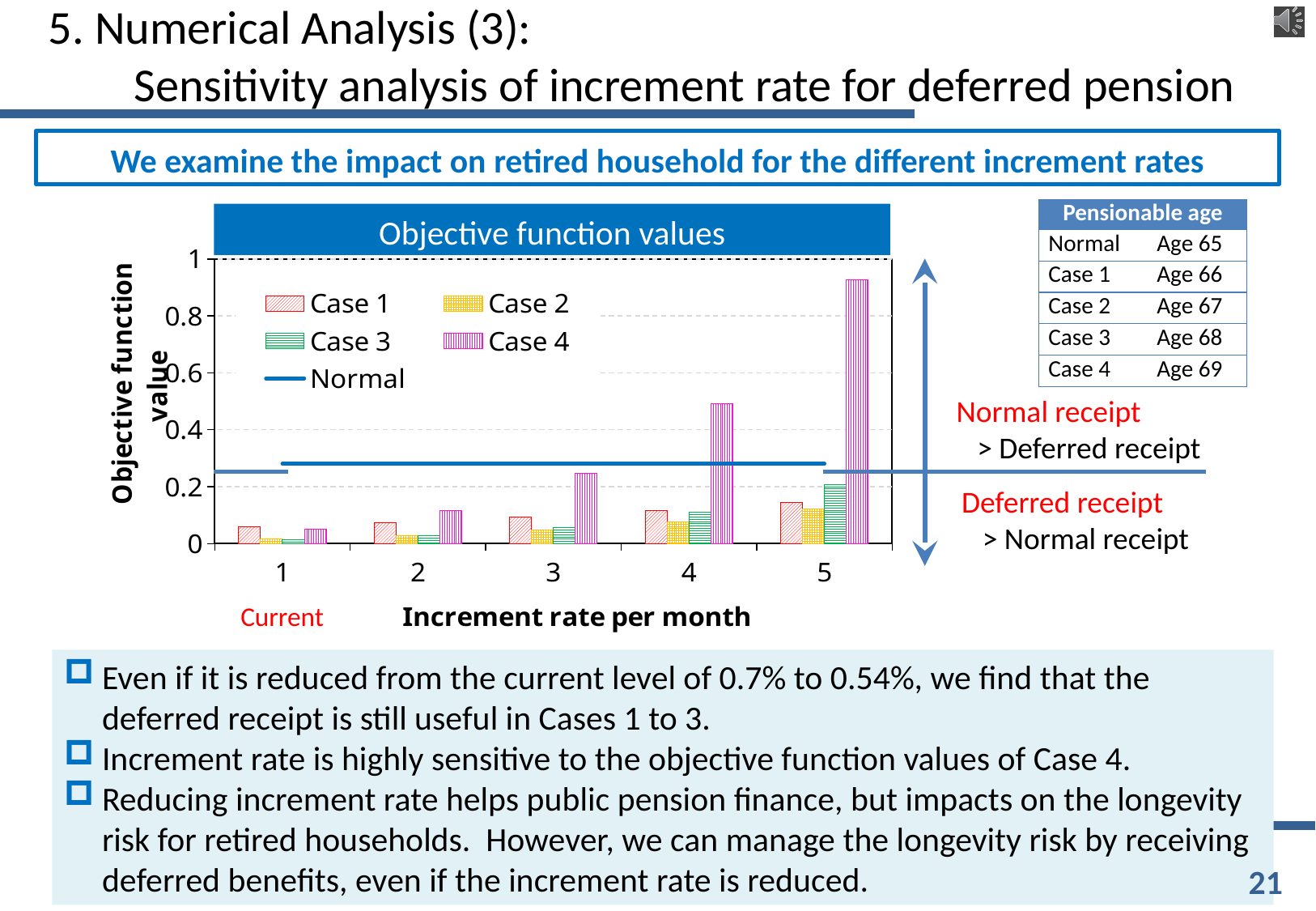
How many increment rate categories are shown on the x axis of the chart? 5 Is the value for Case 4 at increment rate 4 greater or less than 0.6? less Is the value for Case 1 at increment rate 5 greater or less than 0.2? less How many series does the legend of the chart list? 5 What kind of chart is used to show the objective function values? combination bar and line chart What is the title of the chart? Objective function values Do the Case 4 values rise or fall as the increment rate increases from 1 to 5? rise Which series has the highest bar at increment rate 5? Case 4 Is the value for Case 4 at increment rate 5 greater or less than 0.8? greater At increment rate 4, which is larger: Case 4 or Case 1? Case 4 Which series has the tallest bar anywhere in the chart? Case 4